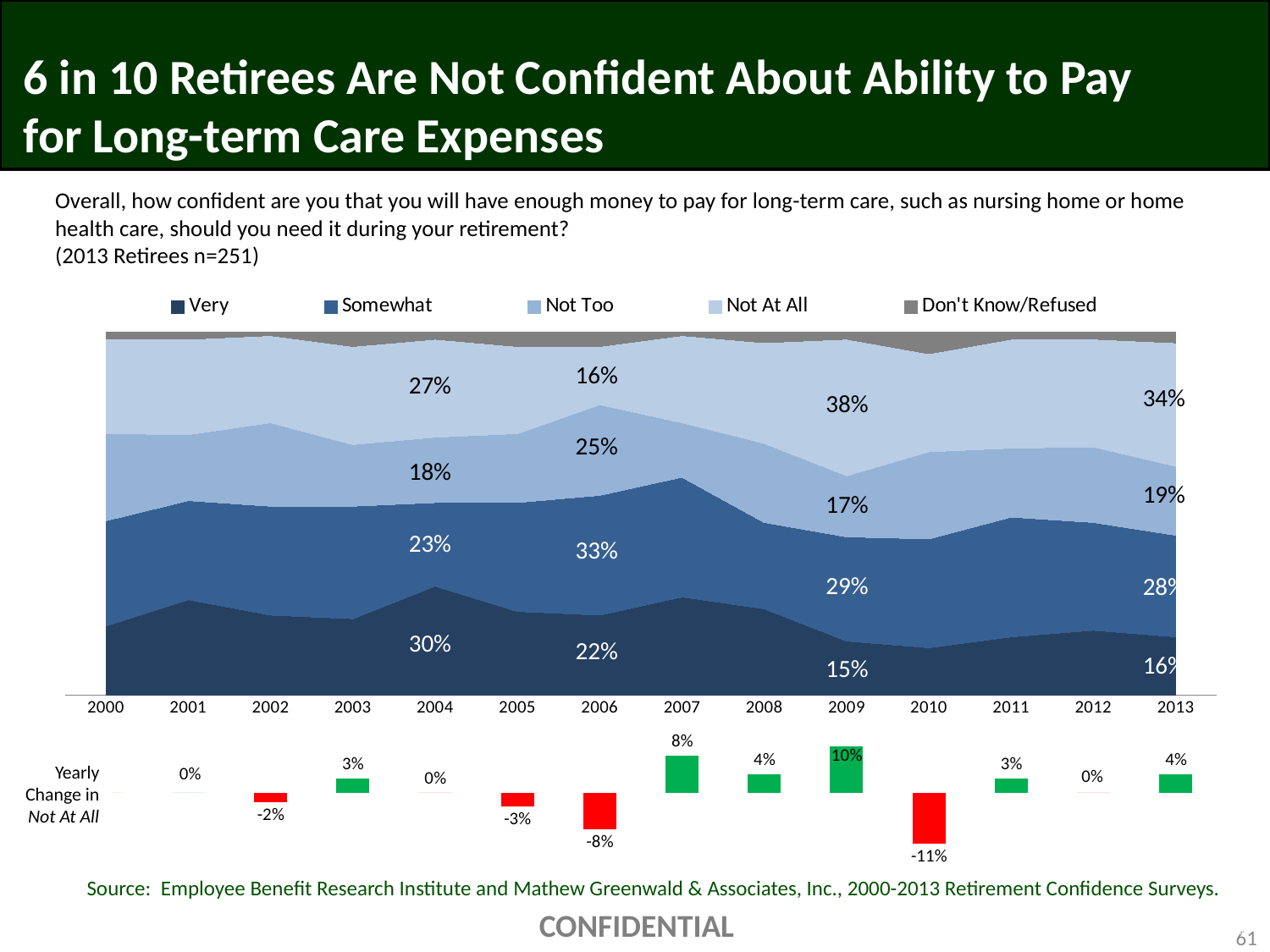
In the main chart, which is larger in 2006: Very or Somewhat? Somewhat In the main chart, how many series does the legend list? 5 In the Yearly Change in Not At All chart, which year has the highest value? 2009 In the main chart, what is the value for Not At All in 2009? 38% In the main chart, what is the value for Somewhat in 2006? 33% In the main chart, what is the value for Not Too in 2004? 18% What kind of chart is the Yearly Change in Not At All chart at the bottom of the slide? bar chart In the main chart, how many years are shown on the x axis? 14 In the Yearly Change in Not At All chart, what is the value for 2006? -8% In the main chart, what is the difference between the Not At All values in 2009 and 2013? 4% In the main chart, what is the value for Very in 2013? 16% In the Yearly Change in Not At All chart, which year has the lowest value? 2010